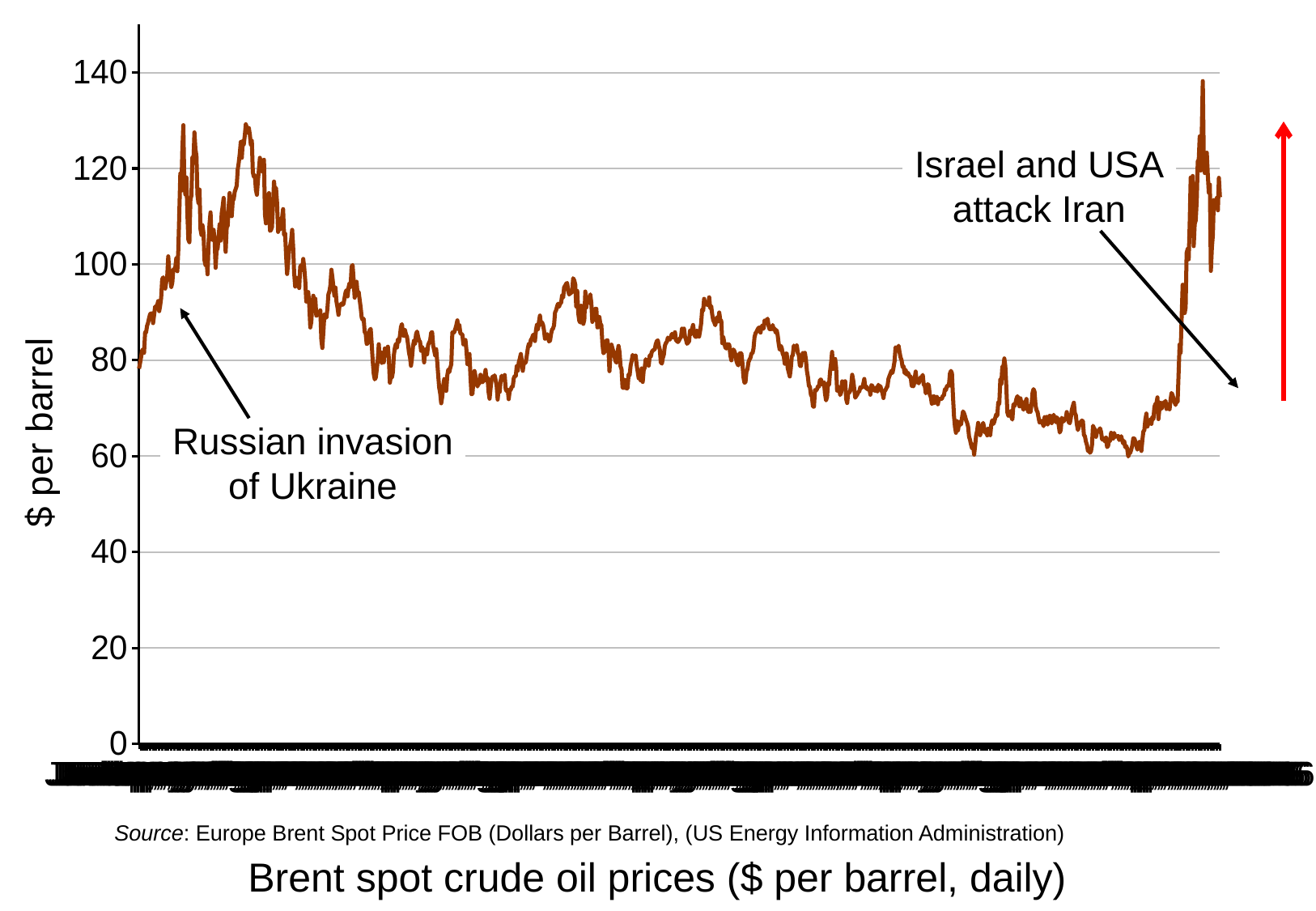
Is the highest value reached after the 'Israel and USA attack Iran' annotation greater or less than 120? greater Is the peak value reached shortly after the 'Russian invasion of Ukraine' annotation greater or less than 120? greater Does the price generally rise or fall between the peak after the Russian invasion of Ukraine and the point where the Israel and USA attack Iran arrow points? Fall What is the label on the vertical axis of the chart? $ per barrel Does the price rise or fall at the far right end of the chart, after the Israel and USA attack Iran annotation? Rise What is the title of the chart? Brent spot crude oil prices ($ per barrel, daily) Is the highest value reached after the 'Israel and USA attack Iran' annotation greater or less than 140? less What kind of chart is shown on the slide? Line chart Which is larger: the peak after the 'Israel and USA attack Iran' annotation or the peak after the 'Russian invasion of Ukraine' annotation? The peak after the Israel and USA attack Iran annotation How many data series are plotted on the chart? 1